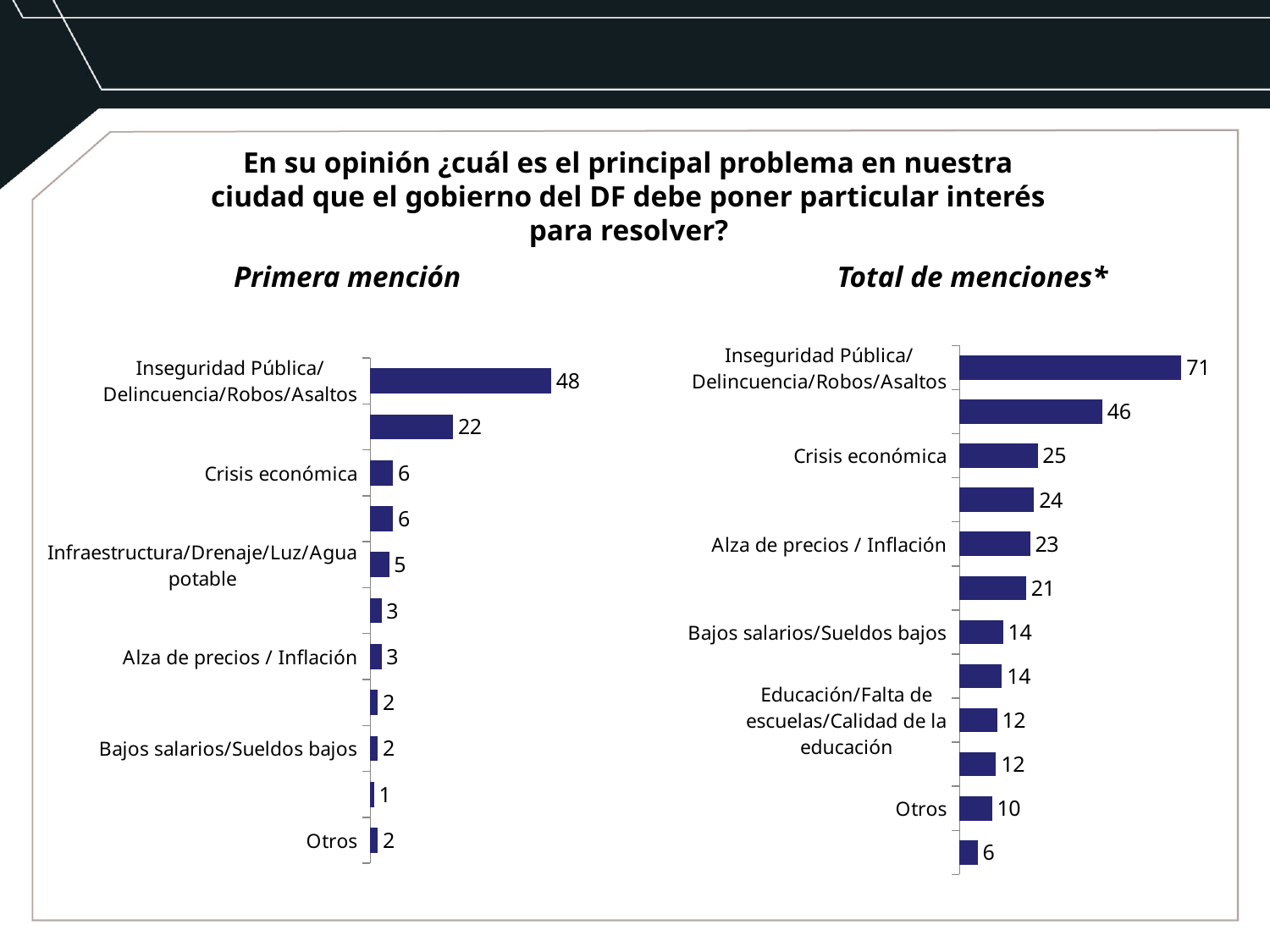
How many bars are plotted in the 'Total de menciones*' chart? 12 In the 'Primera mención' chart, what is the value for Crisis económica? 6 In the 'Total de menciones*' chart, what is the value for Otros? 10 In the 'Total de menciones*' chart, what is the value for Alza de precios / Inflación? 23 In the 'Primera mención' chart, which category has the highest value? Inseguridad Pública/Delincuencia/Robos/Asaltos In the 'Primera mención' chart, what is the value for Inseguridad Pública/Delincuencia/Robos/Asaltos? 48 In the 'Total de menciones*' chart, what is the value for Inseguridad Pública/Delincuencia/Robos/Asaltos? 71 In the 'Primera mención' chart, what is the difference between Inseguridad Pública/Delincuencia/Robos/Asaltos and Crisis económica? 42 In the 'Total de menciones*' chart, what is the difference between Inseguridad Pública/Delincuencia/Robos/Asaltos and Crisis económica? 46 Which chart shows a larger value for Crisis económica, 'Primera mención' or 'Total de menciones*'? Total de menciones* What type of chart is the 'Primera mención' chart? Bar chart In the 'Total de menciones*' chart, what is the lowest value shown? 6